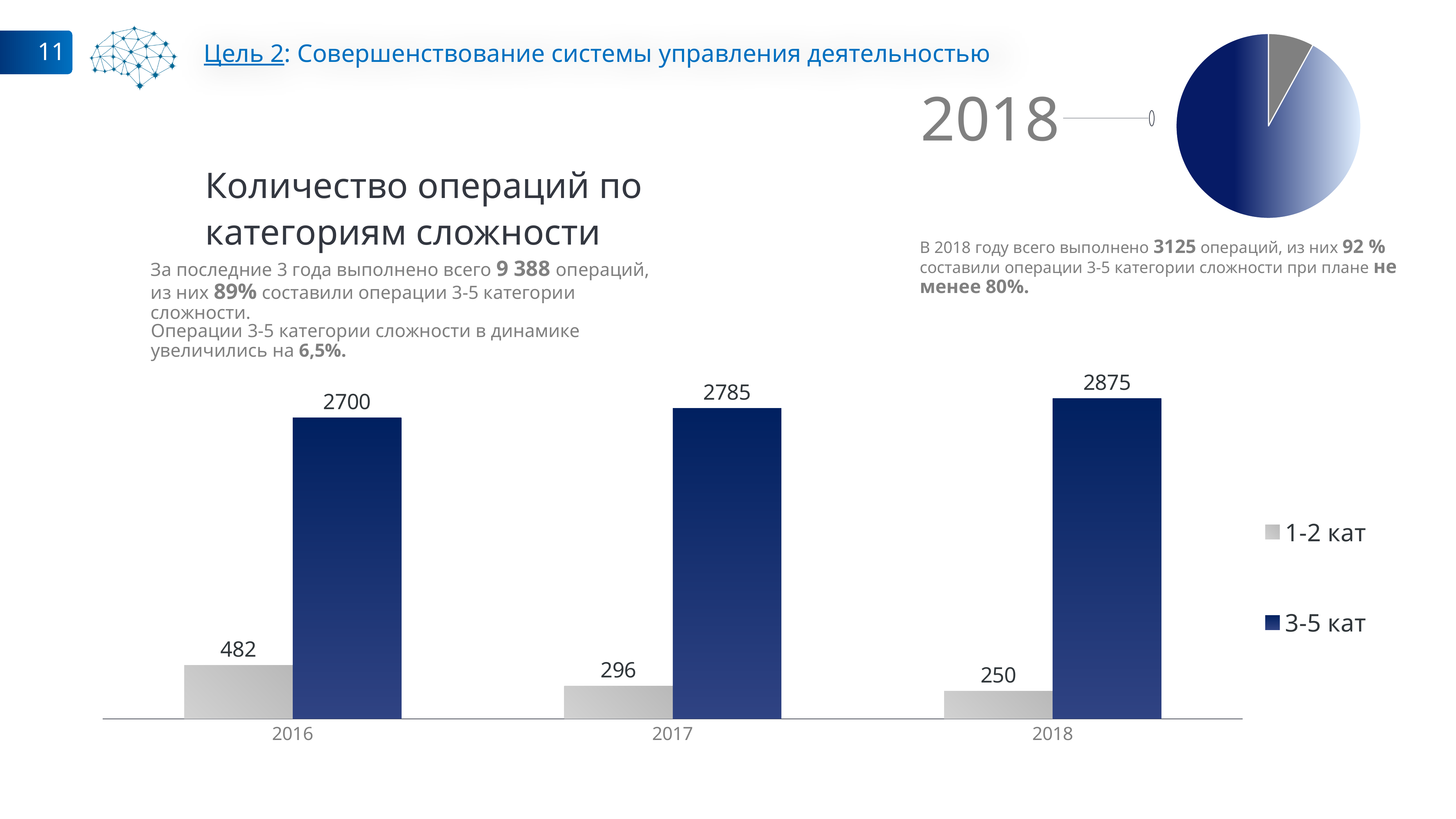
In the bar chart, how many years are shown on the x axis? 3 In the bar chart, do the values for 3-5 кат rise or fall from 2016 to 2018? rise In the bar chart, what is the value for 1-2 кат in 2018? 250 In the bar chart, what is the value for 1-2 кат in 2017? 296 In the bar chart, which year has the lowest value for 3-5 кат? 2016 In the bar chart, how many series does the legend list? 2 In the bar chart, what is the difference between the 1-2 кат values for 2016 and 2018? 232 In the bar chart, what is the value for 3-5 кат in 2018? 2875 In the bar chart, which is larger: 1-2 кат in 2016 or 1-2 кат in 2017? 1-2 кат in 2016 In the bar chart, what is the value for 3-5 кат in 2016? 2700 In the bar chart, which year has the highest value for 1-2 кат? 2016 In the bar chart, what is the difference between the 3-5 кат values for 2018 and 2017? 90